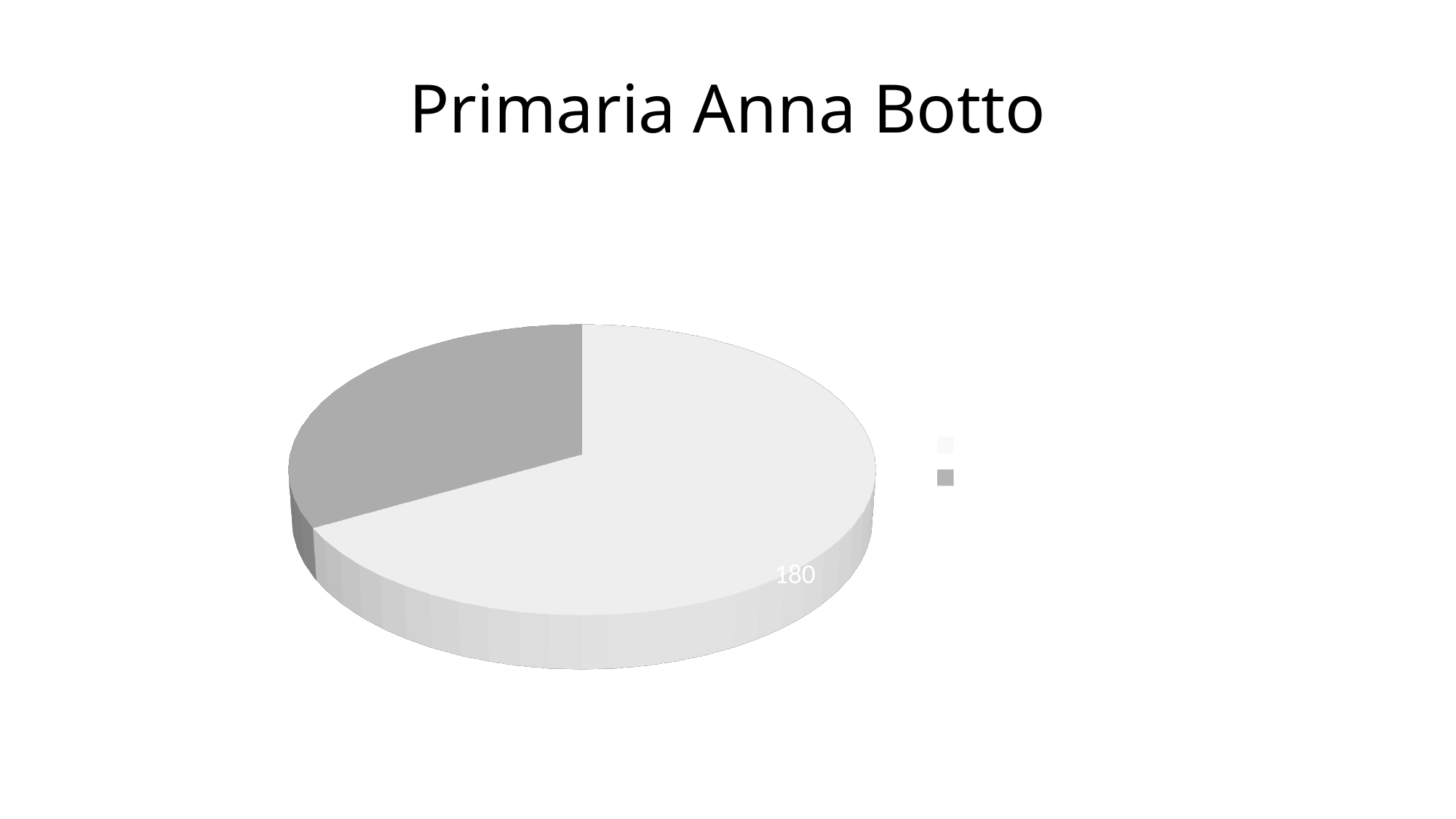
Which slice is larger, the light grey slice or the dark grey slice? the light grey slice What kind of chart is shown on the slide? pie chart What is the title of the chart? Primaria Anna Botto Is the value of the light grey slice greater or less than 100? greater Which slice of the pie is the smallest? the dark grey slice How many entries does the legend list? 2 What value is printed on the large light grey slice of the pie? 180 How many slices does the pie chart have? 2 Which slice of the pie is the largest? the light grey slice Does the light grey slice take up more or less than half of the pie? more